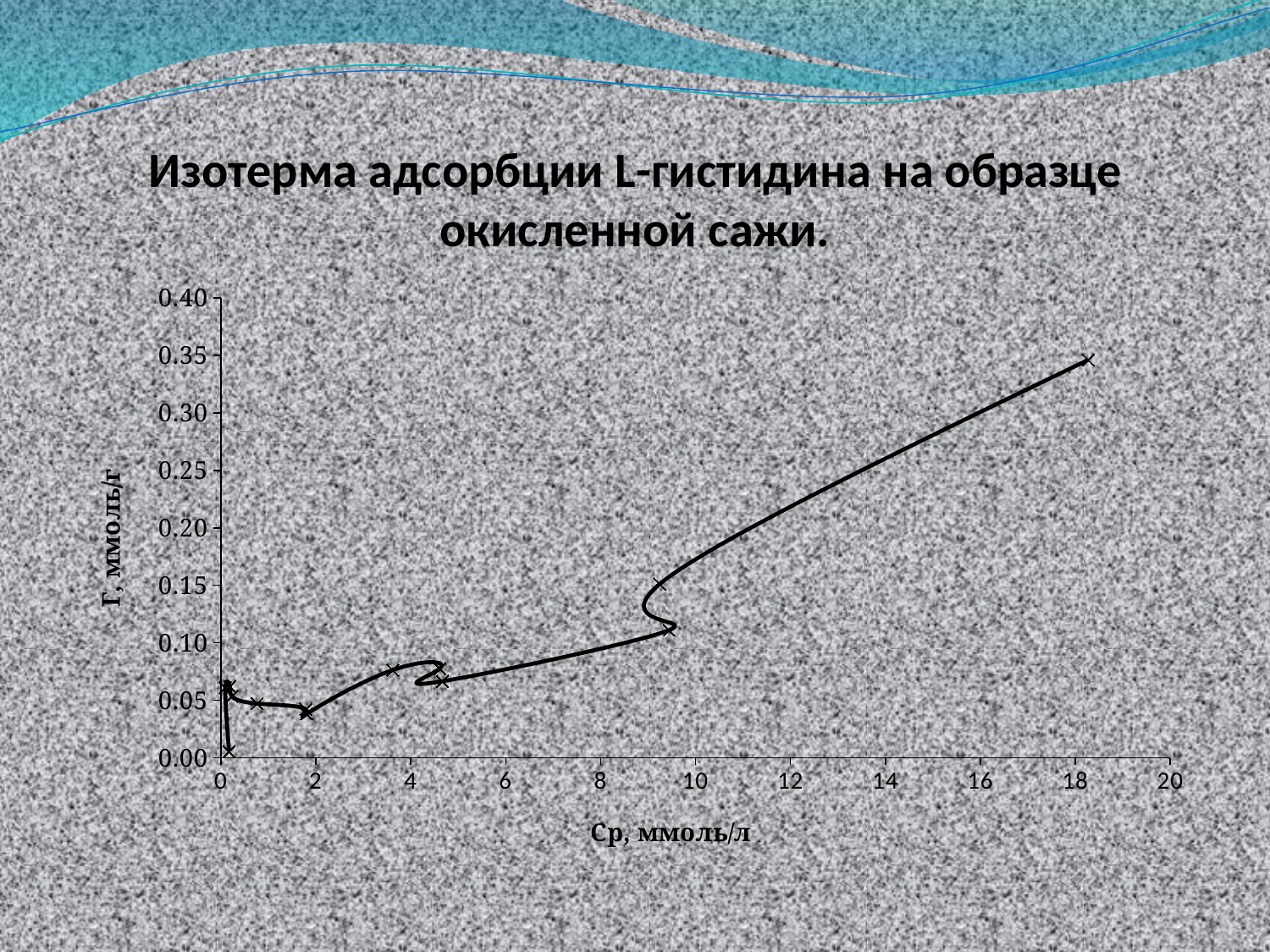
What kind of chart is shown on the slide? Line chart (scatter with smoothed line) Which point has the highest value of Г: the one near Ср = 9 or the one near Ср = 18? the one near Ср = 18 What is the label of the vertical axis? Г, ммоль/г What is the maximum value shown on the vertical axis? 0.40 Is the value of Г for the point near Ср = 3.6 greater or less than 0.10? less Is the value of Г for the point near Ср = 2 greater or less than 0.05? less Is the value of Г for the rightmost point (near Ср = 18) greater or less than 0.30? greater Which of the two points has the larger Г value: the one near Ср = 2 or the one near Ср = 9? the one near Ср = 9 What is the title of the chart? Изотерма адсорбции L-гистидина на образце окисленной сажи. Overall, do the values of Г rise or fall as Ср increases along the x axis? rise